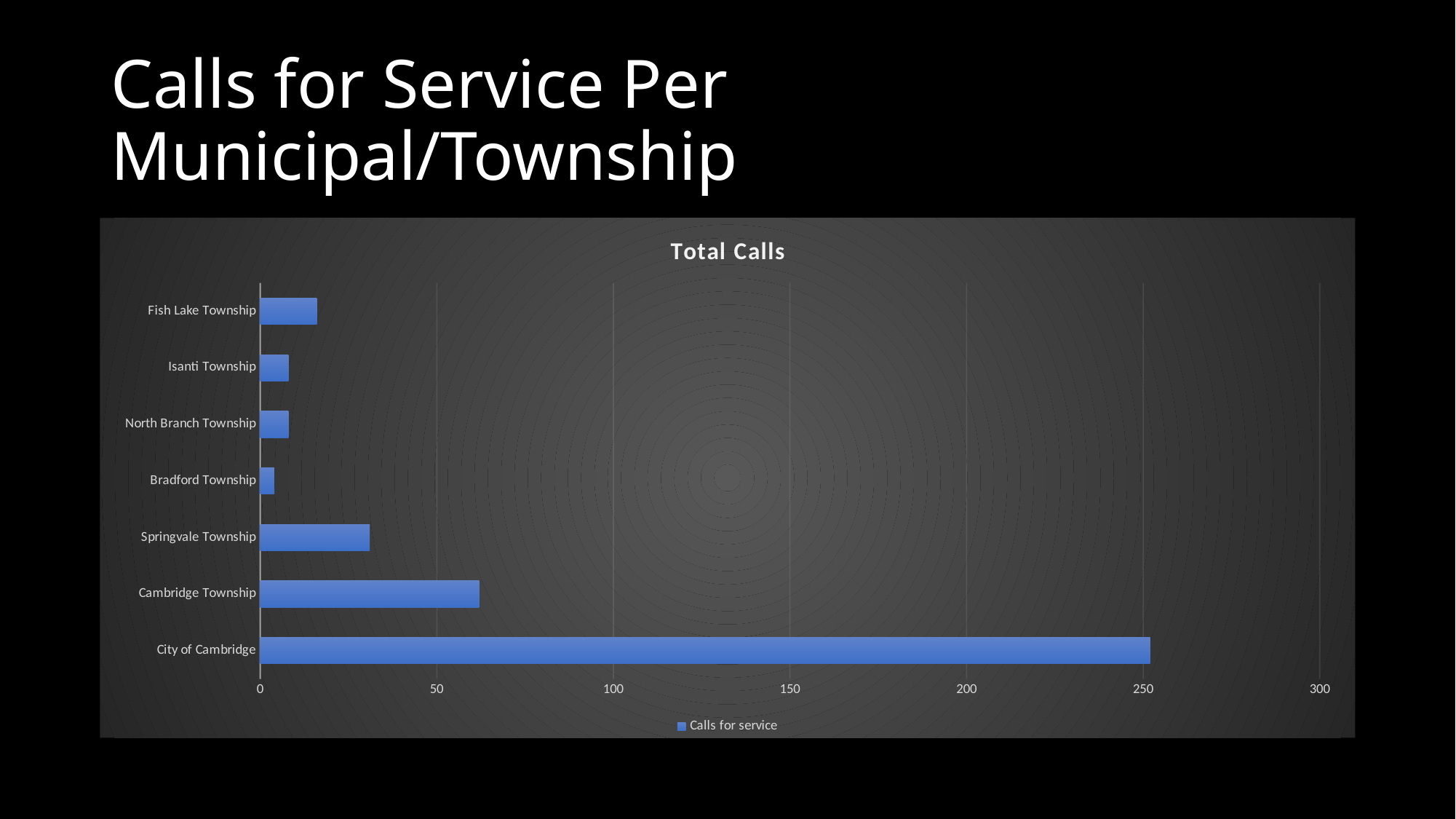
Which municipality/township has the lowest number of total calls? Bradford Township Which municipality/township has the highest number of total calls? City of Cambridge Is the value for Cambridge Township greater or less than 100? less Which has more calls for service, Fish Lake Township or Bradford Township? Fish Lake Township What series name is shown in the chart legend? Calls for service Which has more calls for service, Cambridge Township or Springvale Township? Cambridge Township Is the value for City of Cambridge greater or less than 200? greater What kind of chart is shown on the slide? bar chart Is the value for Springvale Township greater or less than 50? less What is the title of the chart? Total Calls How many series does the legend of the Total Calls chart list? 1 How many municipalities/townships are plotted in the Total Calls chart? 7